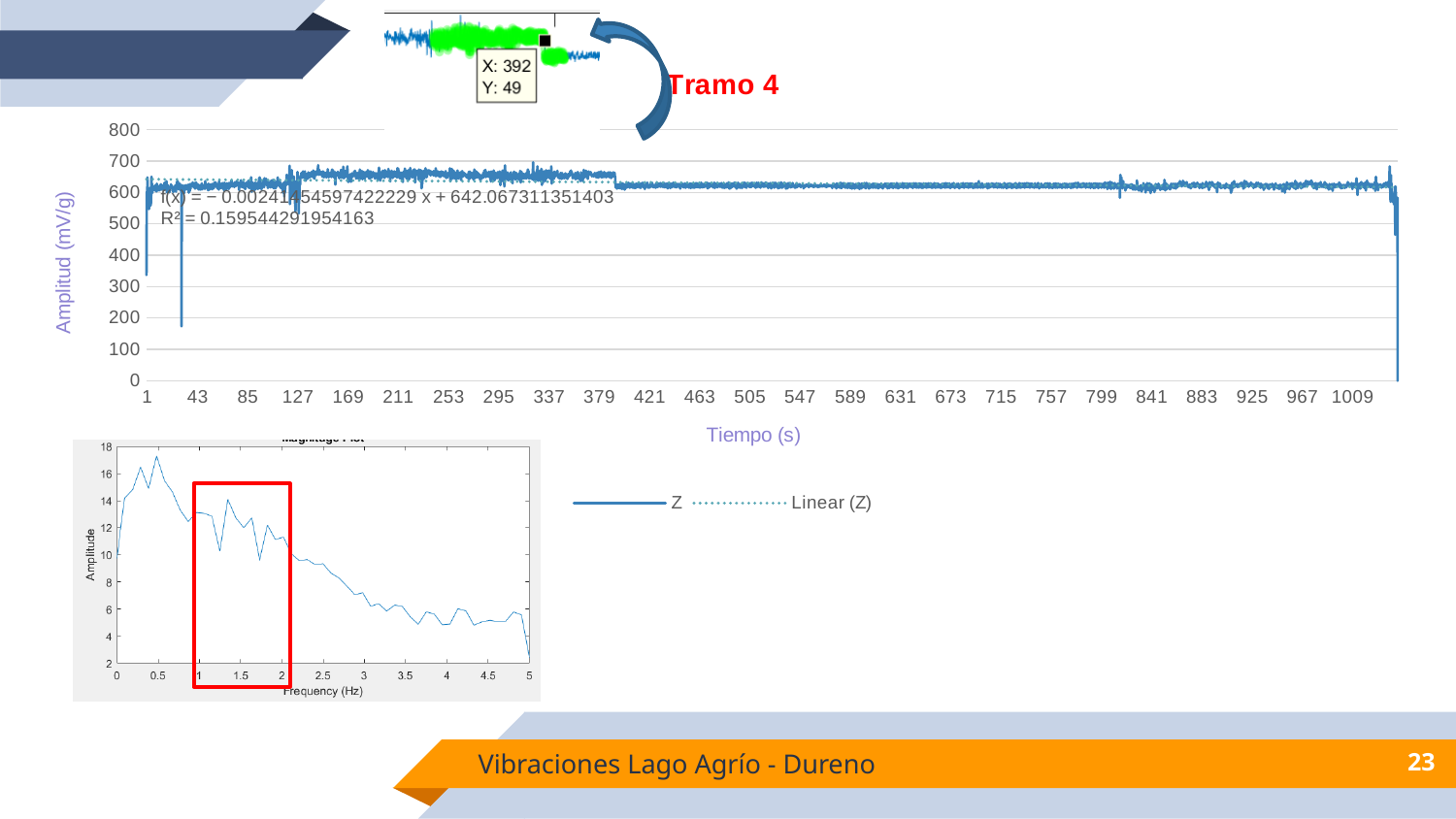
In the small inset at the top of the slide, what X and Y values are shown in the data tip? X: 392, Y: 49 In the main chart with y-axis 'Amplitud (mV/g)', what is the highest tick value shown on the y axis? 800 In the main chart with y-axis 'Amplitud (mV/g)', what is the R² value shown for the linear trendline? 0.159544291954163 In the main chart with y-axis 'Amplitud (mV/g)', what kind of chart is it? line chart In the small chart at the bottom left with x-axis 'Frequency (Hz)', is the Amplitude at 5 Hz greater or less than 6? less In the main chart with y-axis 'Amplitud (mV/g)', how many series does the legend list? 2 In the main chart with y-axis 'Amplitud (mV/g)', what is the intercept of the trendline equation f(x)? 642.067311351403 In the main chart with y-axis 'Amplitud (mV/g)', what is the label of the x axis? Tiempo (s) In the main chart with y-axis 'Amplitud (mV/g)', does the linear trendline for Z rise or fall along the x axis? fall In the main chart with y-axis 'Amplitud (mV/g)', is the value of Z at Tiempo 505 greater or less than 500? greater In the main chart with y-axis 'Amplitud (mV/g)', what are the two legend entries? Z and Linear (Z)